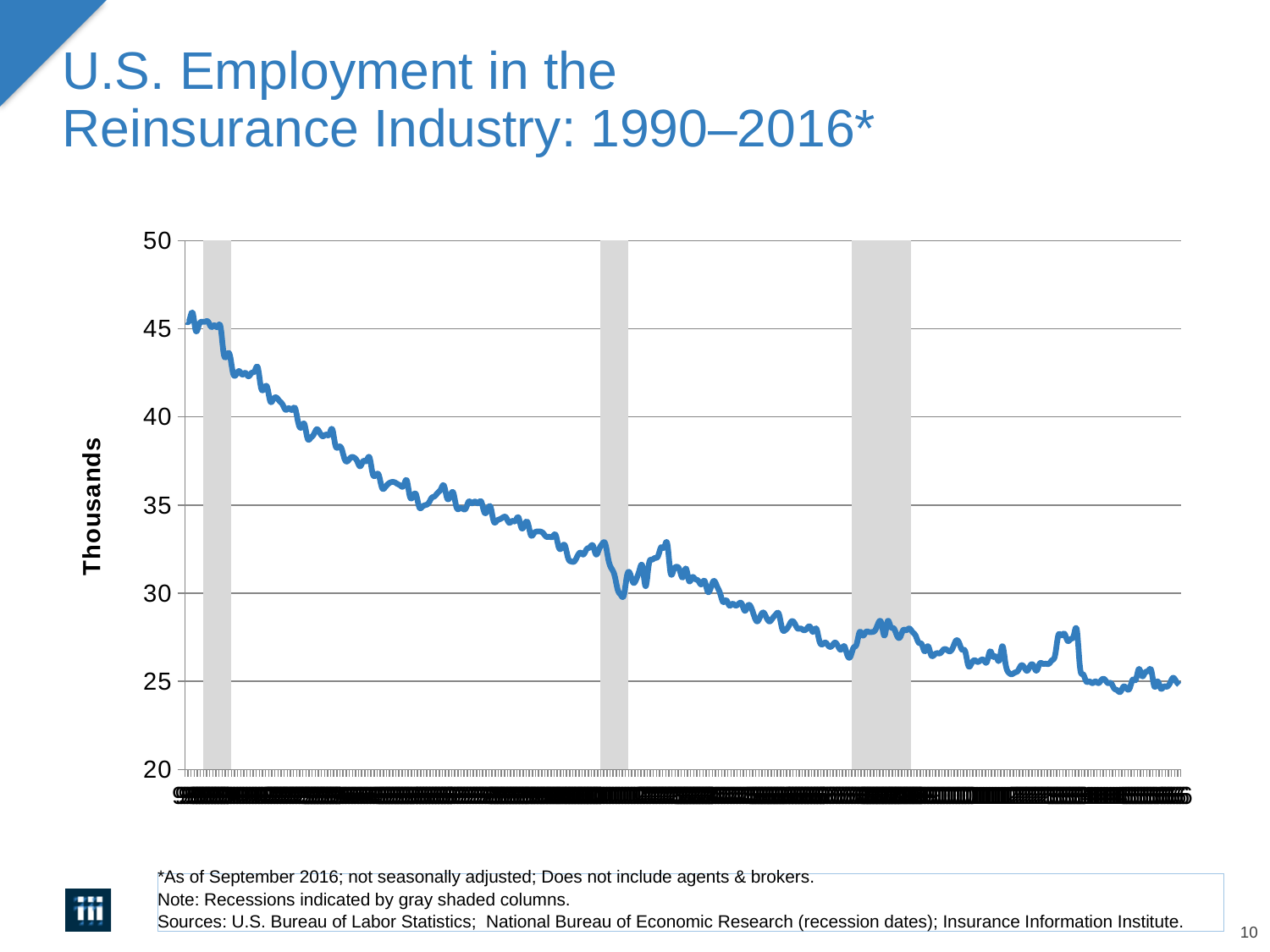
Do the values in the chart generally rise or fall from left to right along the x axis? fall How many gray shaded recession columns are shown on the chart? 3 Is the value at the left end of the line larger or smaller than the value at the right end? larger Is the value at the right end of the line (2016) greater or less than 30? less What is the title of the chart's vertical axis? Thousands Is the value at the left end of the line (1990) greater or less than 40? greater Is the value at the left end of the line greater or less than 50? less What kind of chart is shown on the slide? line chart